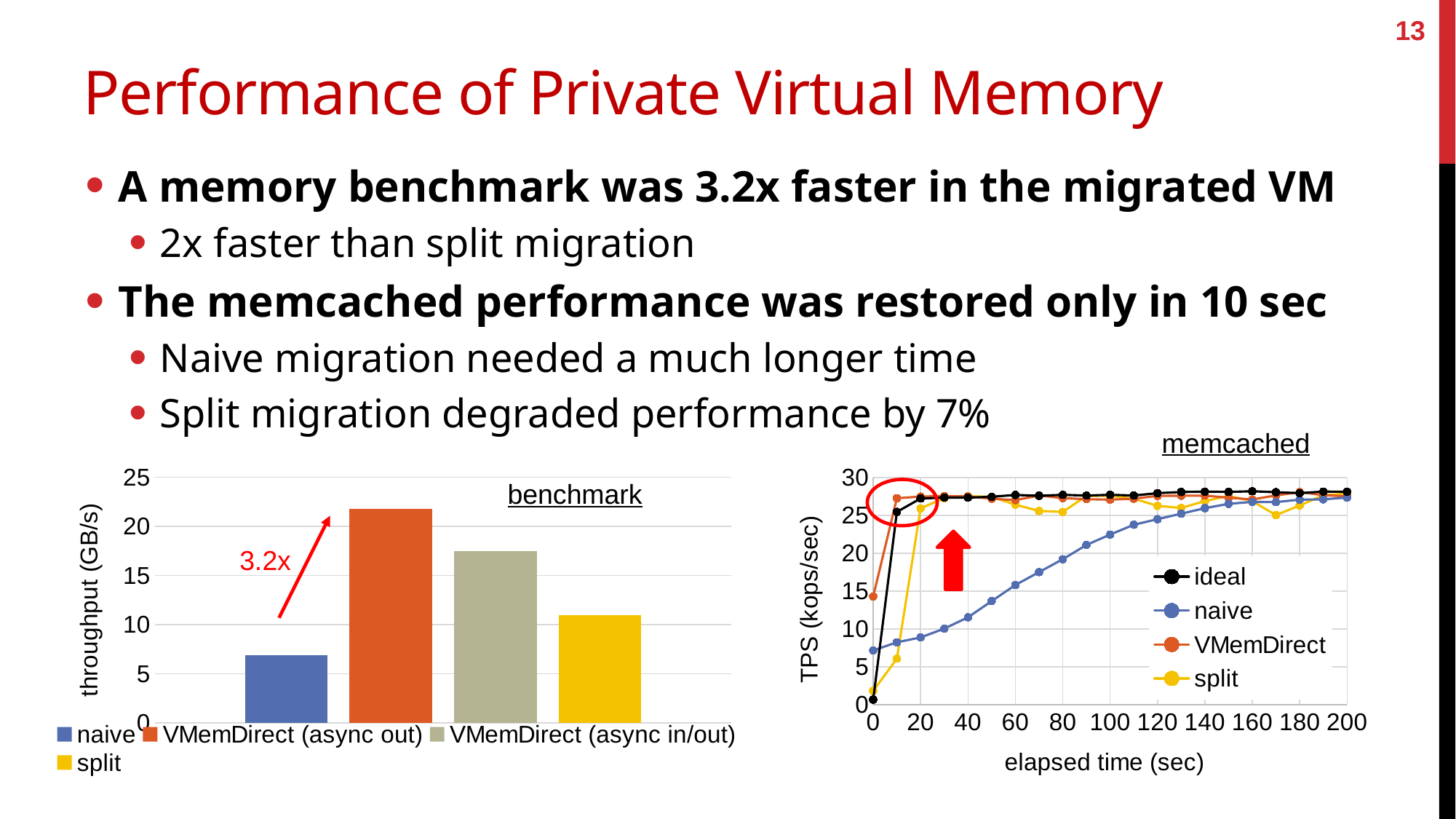
In the benchmark chart, which has higher throughput: VMemDirect (async in/out) or split? VMemDirect (async in/out) In the memcached chart, does the naive series rise or fall as elapsed time increases? rises In the memcached chart, what is the label of the x axis? elapsed time (sec) What kind of chart is the benchmark chart on the left? bar chart In the benchmark chart, which configuration has the lowest throughput? naive In the benchmark chart, how many entries does the legend list? 4 In the benchmark chart, how many bars are plotted? 4 In the benchmark chart, is the throughput for VMemDirect (async out) greater or less than 20? greater In the benchmark chart, is the throughput for naive greater or less than 10? less What kind of chart is the memcached chart on the right? line chart In the memcached chart, how many series does the legend list? 4 In the benchmark chart, which configuration has the highest throughput? VMemDirect (async out)